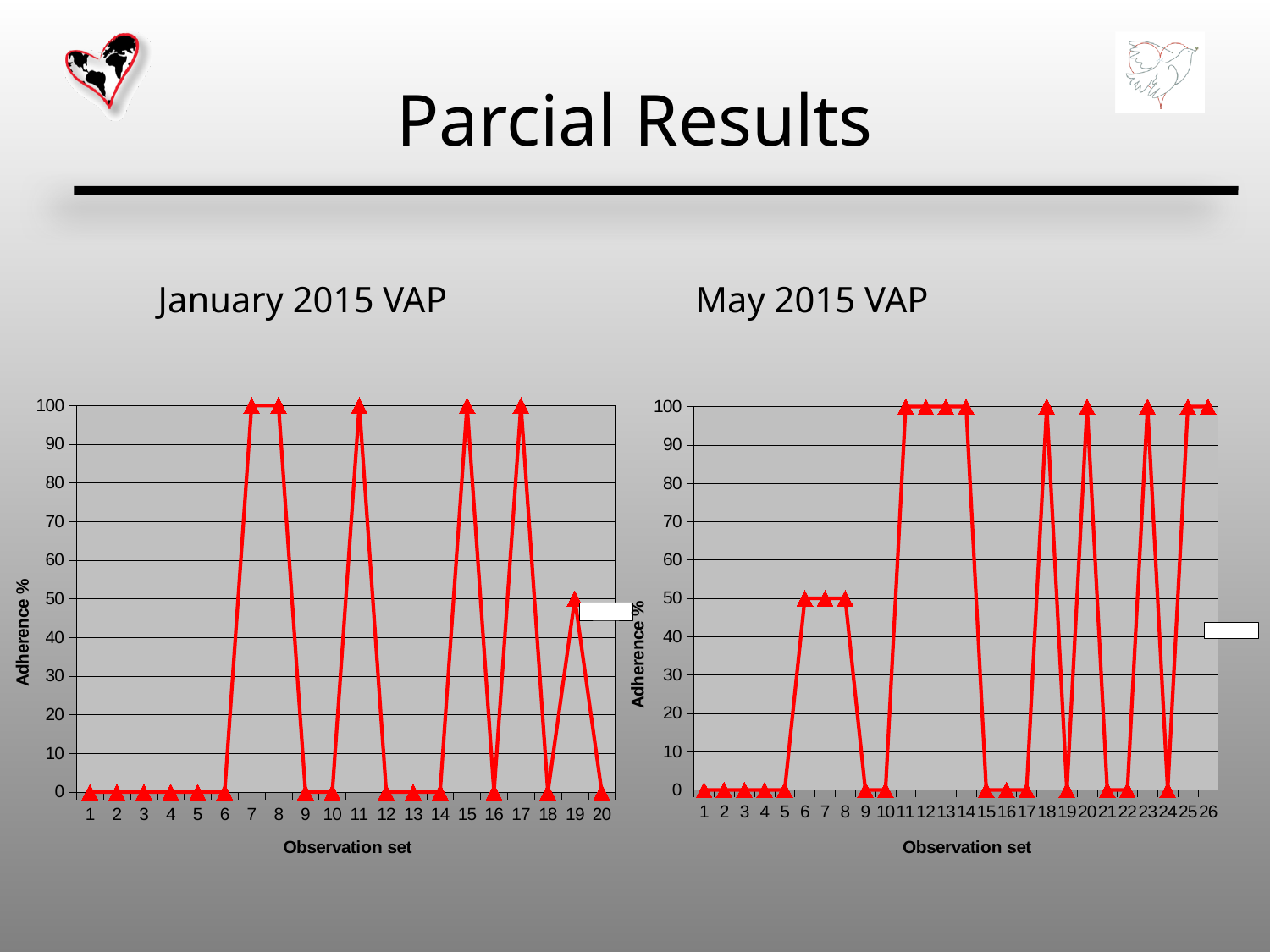
In the January 2015 VAP chart, what is the difference in adherence % between observation set 11 and observation set 19? 50 How many observation sets are plotted in the January 2015 VAP chart? 20 How many observation sets are plotted in the May 2015 VAP chart? 26 In the May 2015 VAP chart, what is the adherence % for observation set 3? 0 In the January 2015 VAP chart, what is the adherence % for observation set 19? 50 What is the label on the x axis of the May 2015 VAP chart? Observation set In the May 2015 VAP chart, which has the higher adherence %, observation set 6 or observation set 11? observation set 11 In the January 2015 VAP chart, what is the adherence % for observation set 7? 100 In the May 2015 VAP chart, what is the adherence % for observation set 18? 100 In the May 2015 VAP chart, what is the adherence % for observation set 7? 50 What type of chart is the January 2015 VAP chart? line chart What is the label on the y axis of the January 2015 VAP chart? Adherence %